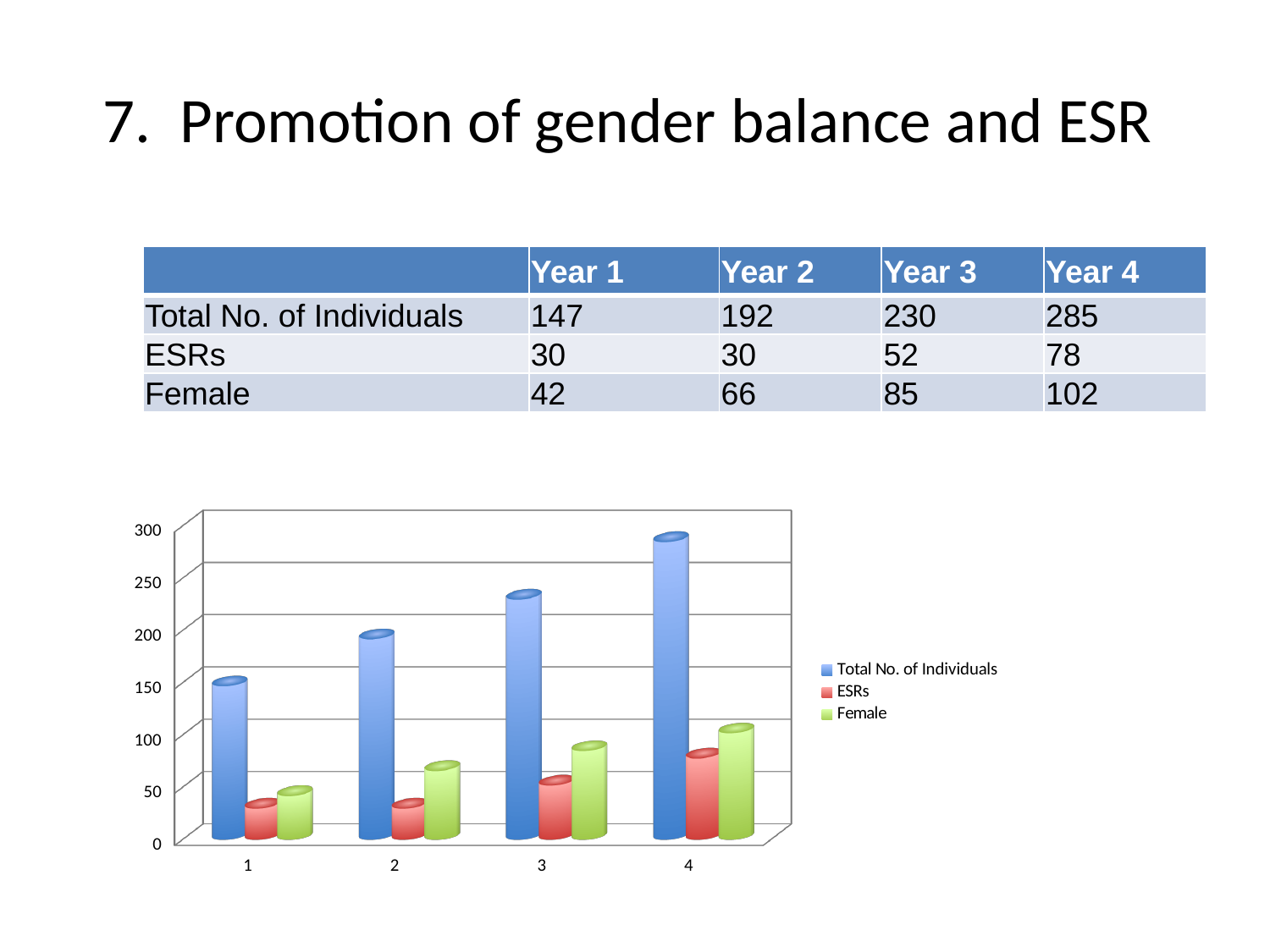
Is the Total No. of Individuals bar for category 2 greater or less than 150? greater What is the Total No. of Individuals in Year 4? 285 What is the difference between the Total No. of Individuals in Year 4 and Year 1? 138 How many categories are shown along the x axis of the chart? 4 Do the Total No. of Individuals values rise or fall from category 1 to category 4? rise In which year is the Total No. of Individuals highest? Year 4 What is the Female value in Year 2? 66 What is the number of ESRs in Year 3? 52 What kind of chart is shown on the slide? bar chart In which year is the Female value lowest? Year 1 Which is larger in Year 3, ESRs or Female? Female How many series does the chart legend list? 3